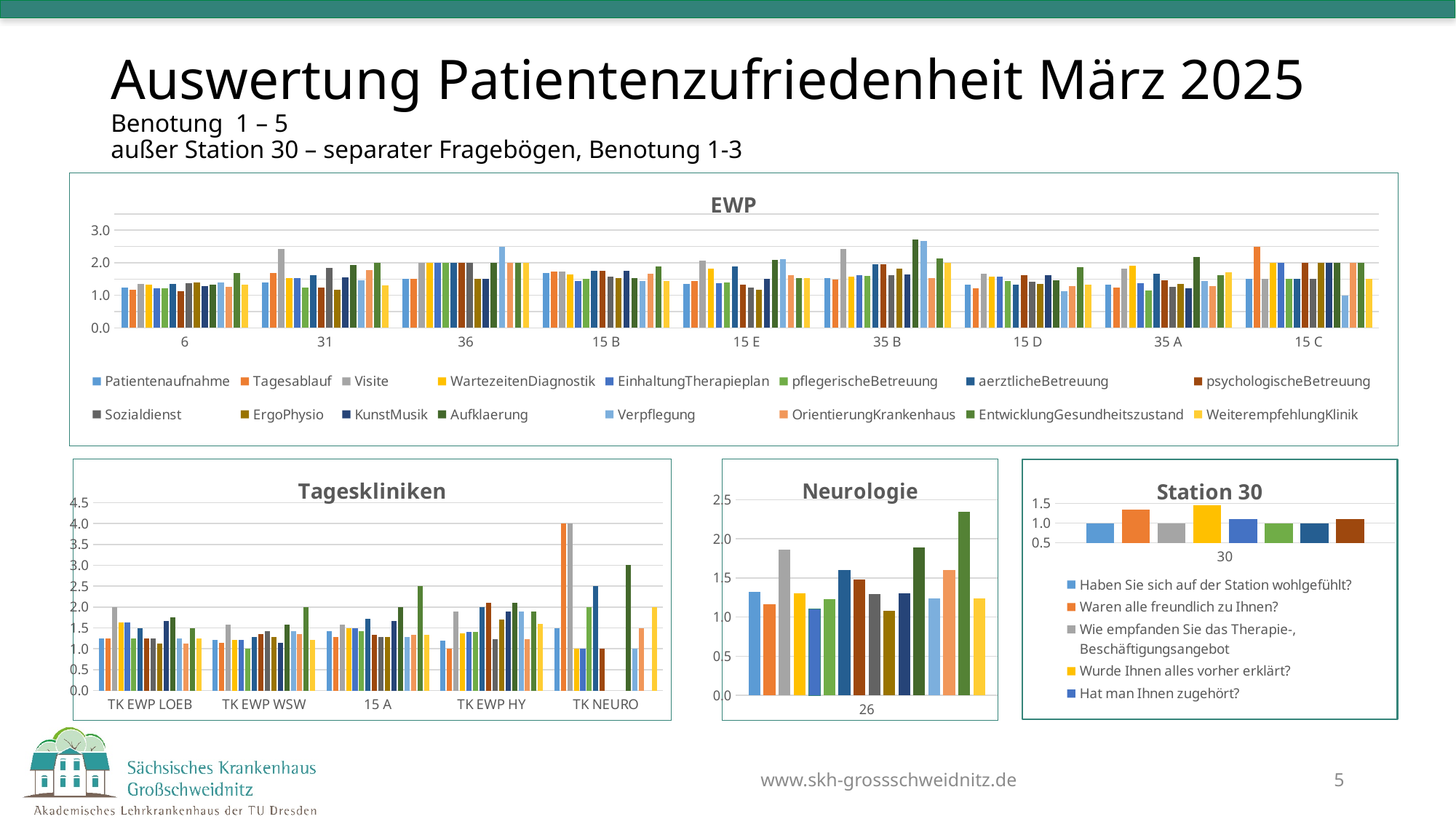
In the EWP chart, is the value of Visite for station 31 greater or less than 2.0? greater How many categories are shown on the x axis of the Tageskliniken chart? 5 In the Tageskliniken chart, is the tallest bar for TK NEURO greater or less than 3.5? greater How many categories (stations) are shown on the x axis of the EWP chart? 9 In the Neurologie chart, is the tallest bar greater or less than 2.0? greater How many series does the legend of the EWP chart list? 16 In the Station 30 chart, which legend entry has the highest value? Wurde Ihnen alles vorher erklärt? In the Tageskliniken chart, which category contains the tallest bars? TK NEURO What kind of chart is the EWP chart at the top of the slide? bar chart What is the category label on the x axis of the Neurologie chart? 26